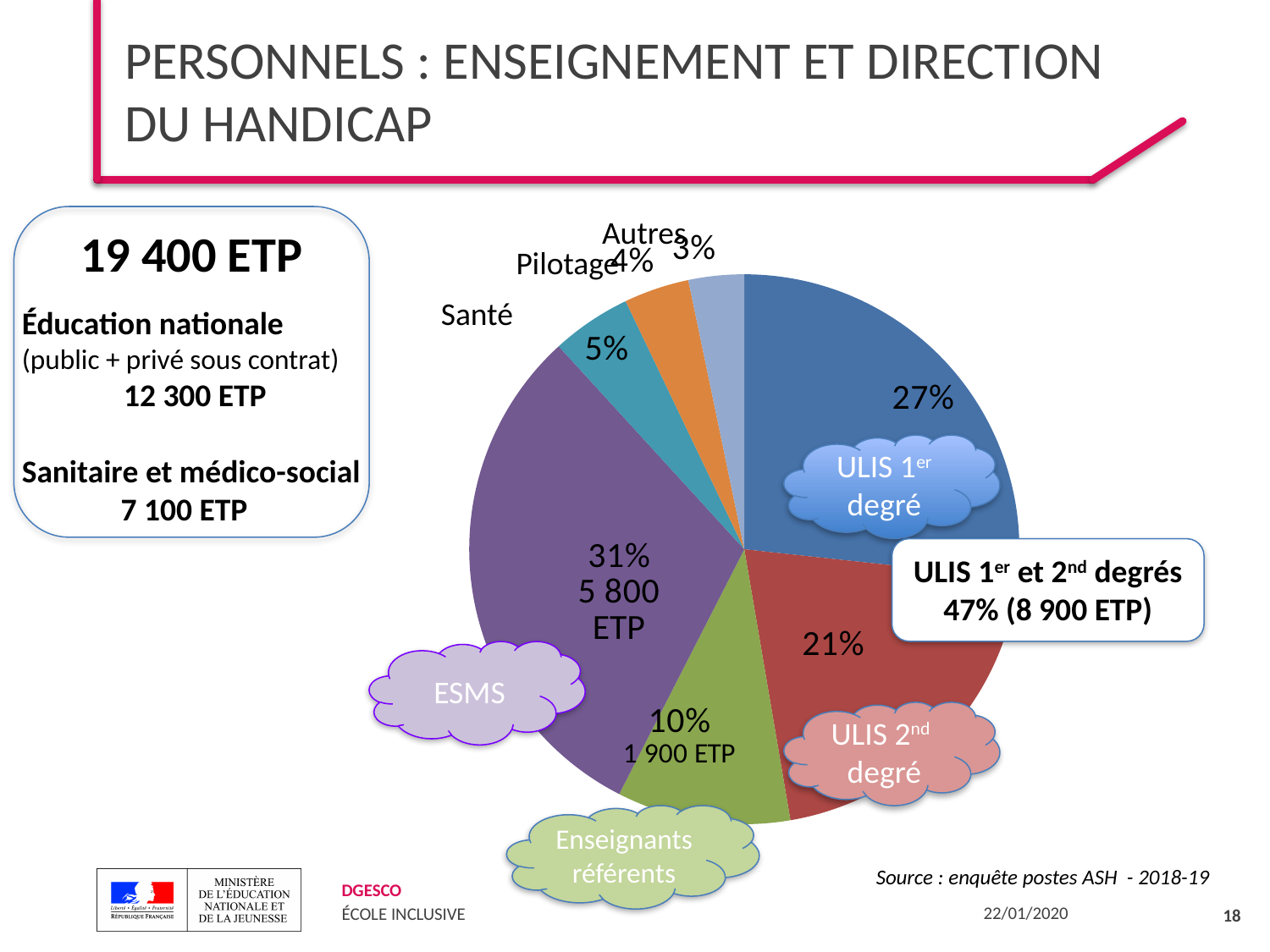
What share of the pie does ULIS 1er degré represent? 27% What share of the pie does ULIS 2nd degré represent? 21% What is the difference in percentage points between ULIS 1er degré and ULIS 2nd degré? 6 What percentage is shown for Santé? 5% What percentage is shown for Pilotage? 4% Which slice of the pie chart is the smallest? Autres What share of the pie does ESMS represent? 31% What kind of chart is shown on the slide? pie chart How many ETP are shown for the Enseignants référents slice? 1 900 ETP How many slices does the pie chart have? 7 Which slice of the pie chart is the largest? ESMS